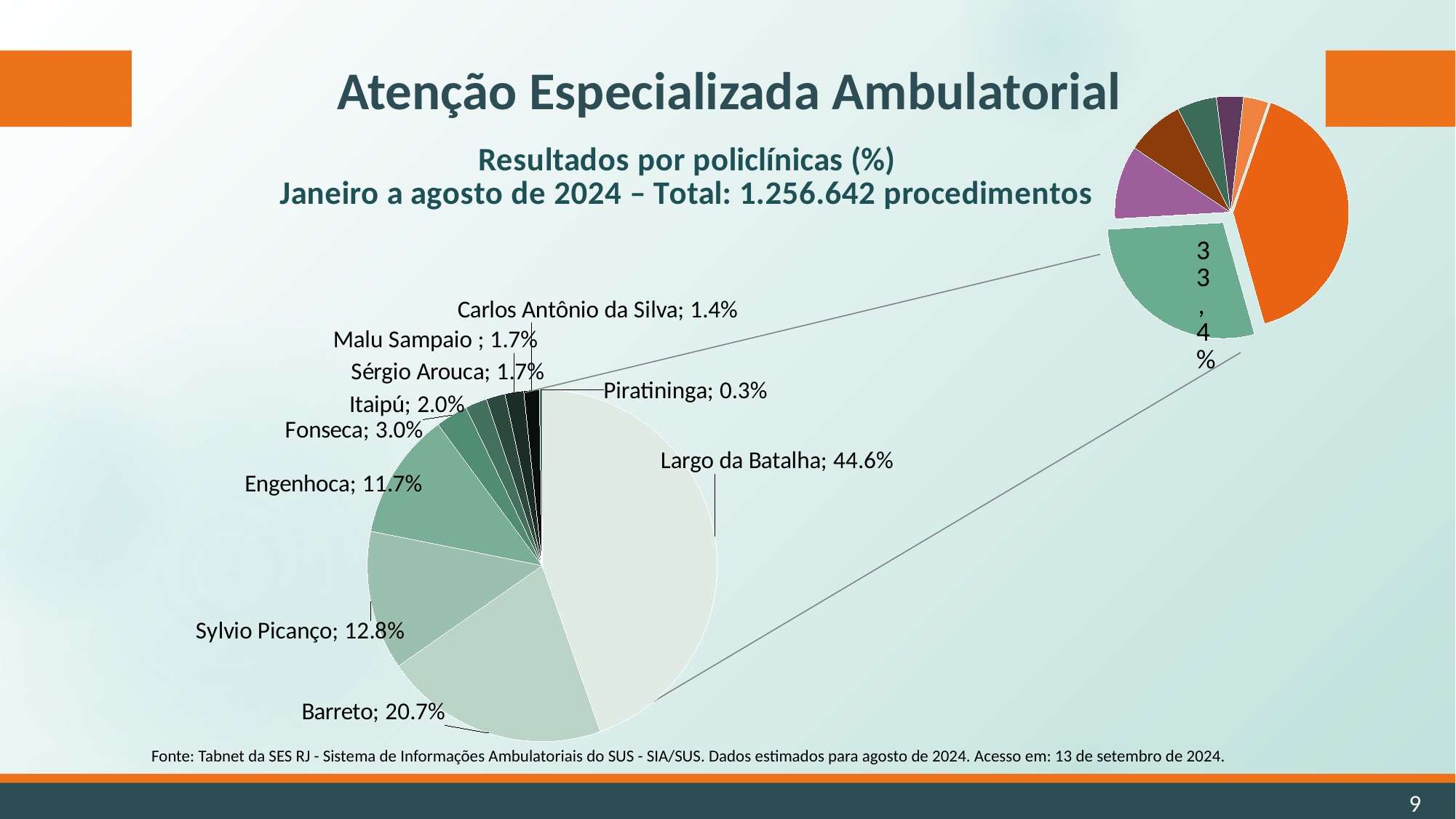
In the breakdown pie chart, what share does Largo da Batalha have? 44.6% What percentage is printed on the exploded slice of the small pie chart at the top right? 33,4% In the breakdown pie chart, what share does Piratininga have? 0.3% In the breakdown pie chart, what share does Engenhoca have? 11.7% In the breakdown pie chart, which has a larger share, Sylvio Picanço or Engenhoca? Sylvio Picanço How many policlínicas are labelled in the breakdown pie chart? 10 In the breakdown pie chart, what share does Barreto have? 20.7% What kind of chart is used on this slide? Pie chart In the breakdown pie chart, what is the difference in percentage points between Largo da Batalha and Barreto? 23.9 In the breakdown pie chart, which policlínica has the smallest share? Piratininga In the breakdown pie chart, which policlínica has the largest share? Largo da Batalha What total number of procedimentos is stated in the chart subtitle? 1.256.642